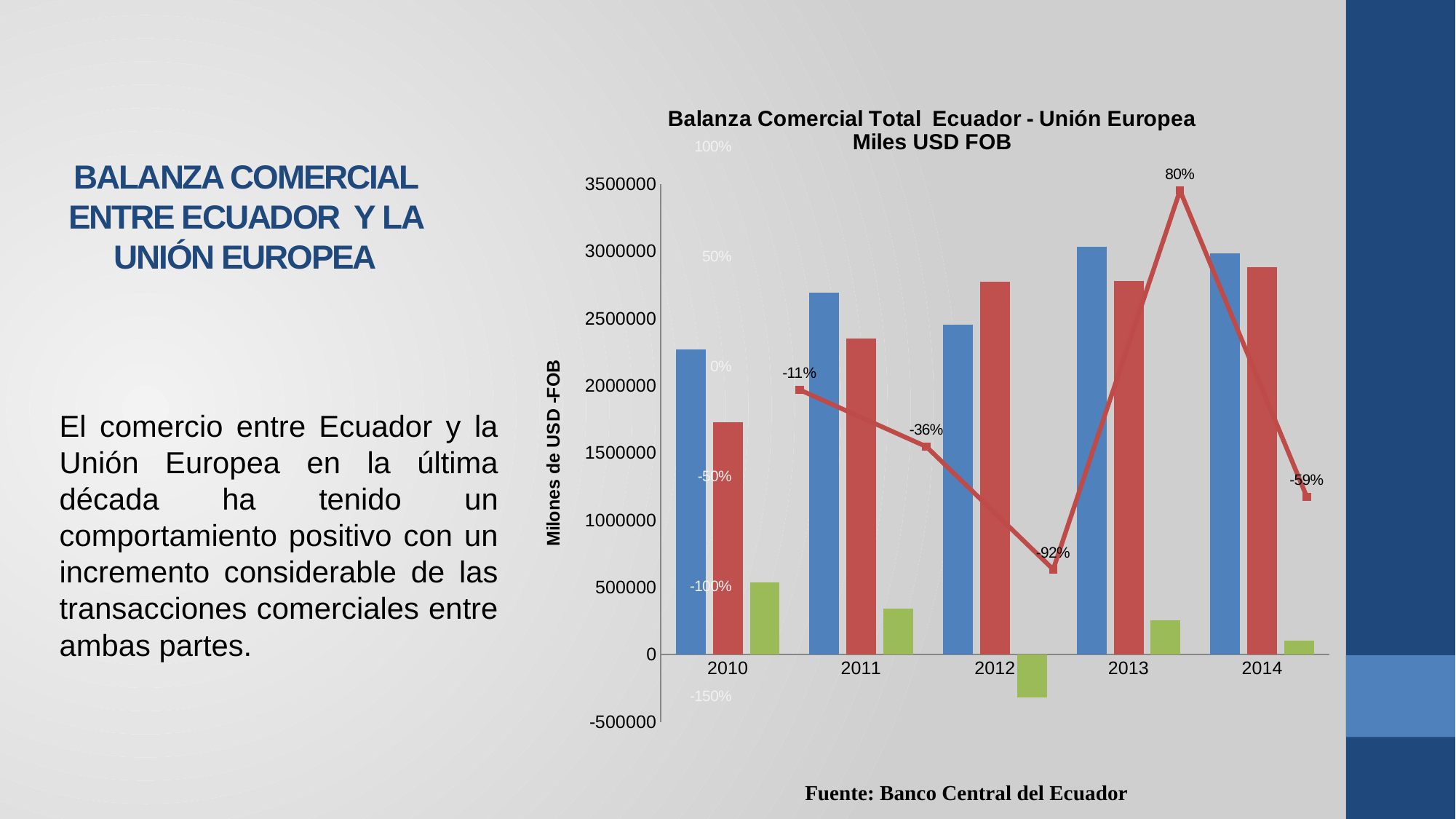
In which year is the blue bar the tallest? 2013 How many labelled points does the line in the chart have? 5 What is the lowest percentage label shown on the line in the chart? -92% In 2010, which bar is taller, the blue bar or the red bar? blue bar How many years are shown on the x axis of the chart? 5 What is the label on the vertical axis of the chart? Milones de USD -FOB How many bars are plotted for each year in the chart? 3 In which year is the green bar the lowest? 2012 What is the highest percentage label shown on the line in the chart? 80% Is the value of the blue bar for 2010 greater or less than 2000000? greater What is the title of the chart? Balanza Comercial Total Ecuador - Unión Europea Miles USD FOB In 2012, which bar is taller, the blue bar or the red bar? red bar